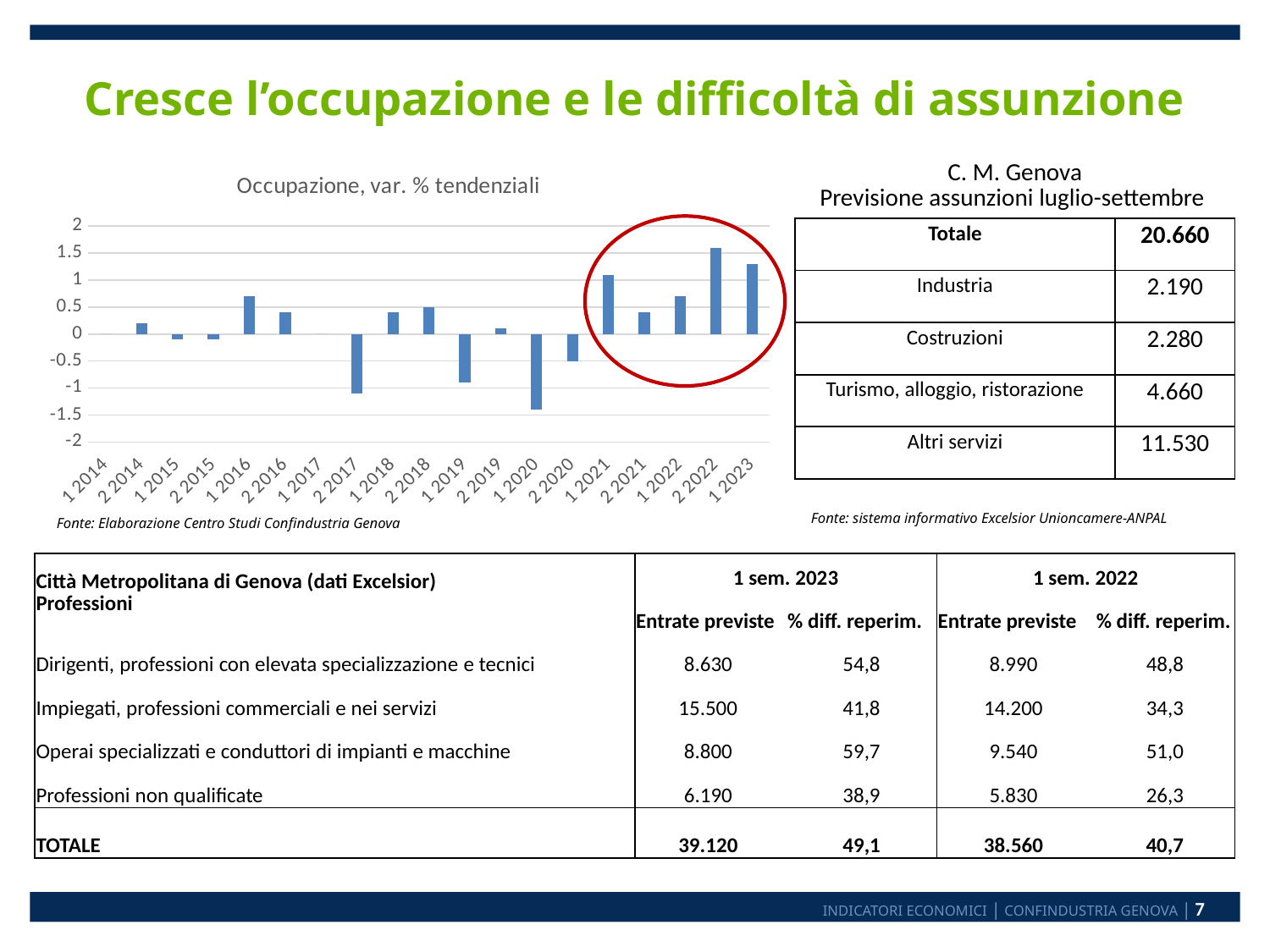
Is the value for 1 2019 greater or less than -0.5? less Which period has the lowest value in the chart? 1 2020 Is the value for 1 2023 greater or less than 1? greater Which is larger, the value for 2 2022 or the value for 1 2023? 2 2022 Which is larger, the value for 1 2020 or the value for 2 2020? 2 2020 Which period has the highest value in the chart? 2 2022 What is the title of the chart on the slide? Occupazione, var. % tendenziali Is the value for 1 2021 greater or less than 1? greater How many periods (categories) are shown on the x axis of the chart? 19 What kind of chart is shown on the slide? bar chart